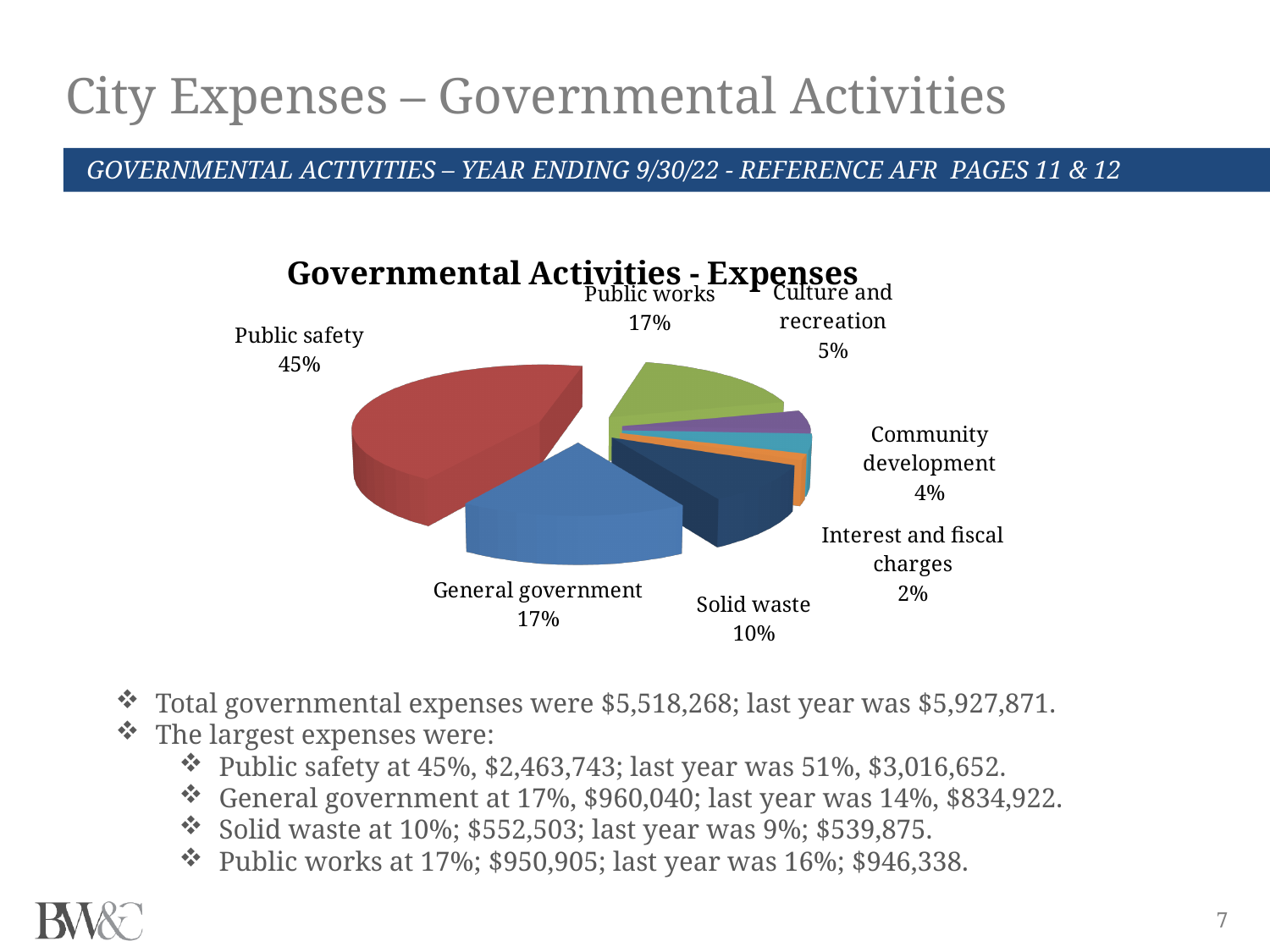
Which category has the largest share of Governmental Activities expenses? Public safety Which category has the smallest share of Governmental Activities expenses? Interest and fiscal charges Which is larger, the share for Solid waste or the share for Culture and recreation? Solid waste What share of Governmental Activities expenses is Public safety? 45% What is the title of the chart? Governmental Activities - Expenses What is the difference in percentage points between Public safety and General government? 28 What kind of chart is shown on the slide? Pie chart What share of Governmental Activities expenses is Interest and fiscal charges? 2% What share of Governmental Activities expenses is Solid waste? 10% How many categories are shown in the Governmental Activities - Expenses pie chart? 7 What share of Governmental Activities expenses is Community development? 4% What is the combined share of Public works and General government? 34%